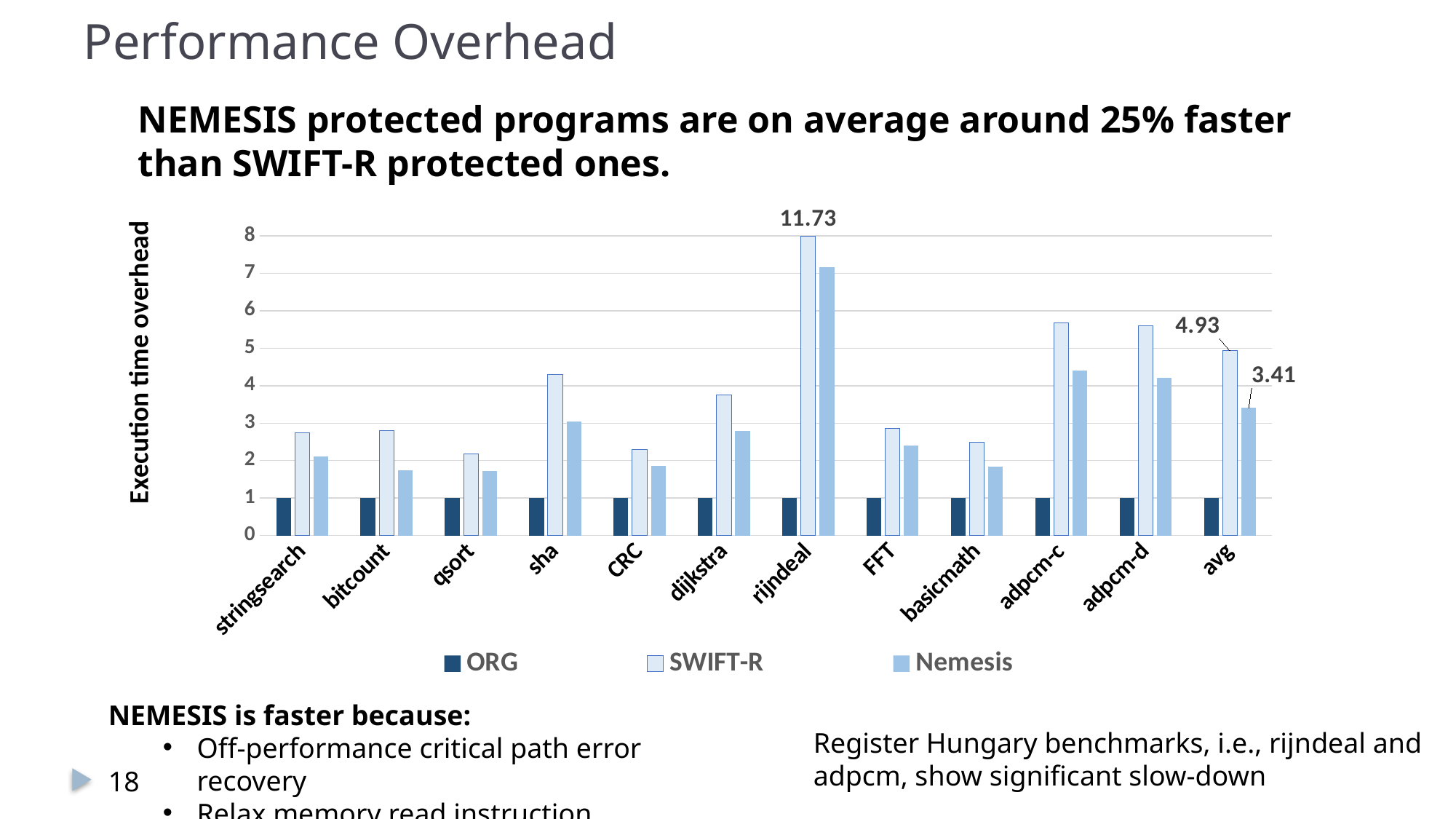
What is the title of the y axis? Execution time overhead How many categories are shown on the x axis? 12 Is the Nemesis value for rijndeal greater or less than 6? greater What is the SWIFT-R value for avg? 4.93 How many series does the legend list? 3 What is the ORG value for stringsearch? 1 What is the difference between the SWIFT-R and Nemesis values for avg? 1.52 What kind of chart is shown on the slide? bar chart Which is larger for adpcm-c, the SWIFT-R value or the Nemesis value? SWIFT-R Which category has the highest SWIFT-R value? rijndeal What is the SWIFT-R value for rijndeal? 11.73 What is the Nemesis value for avg? 3.41